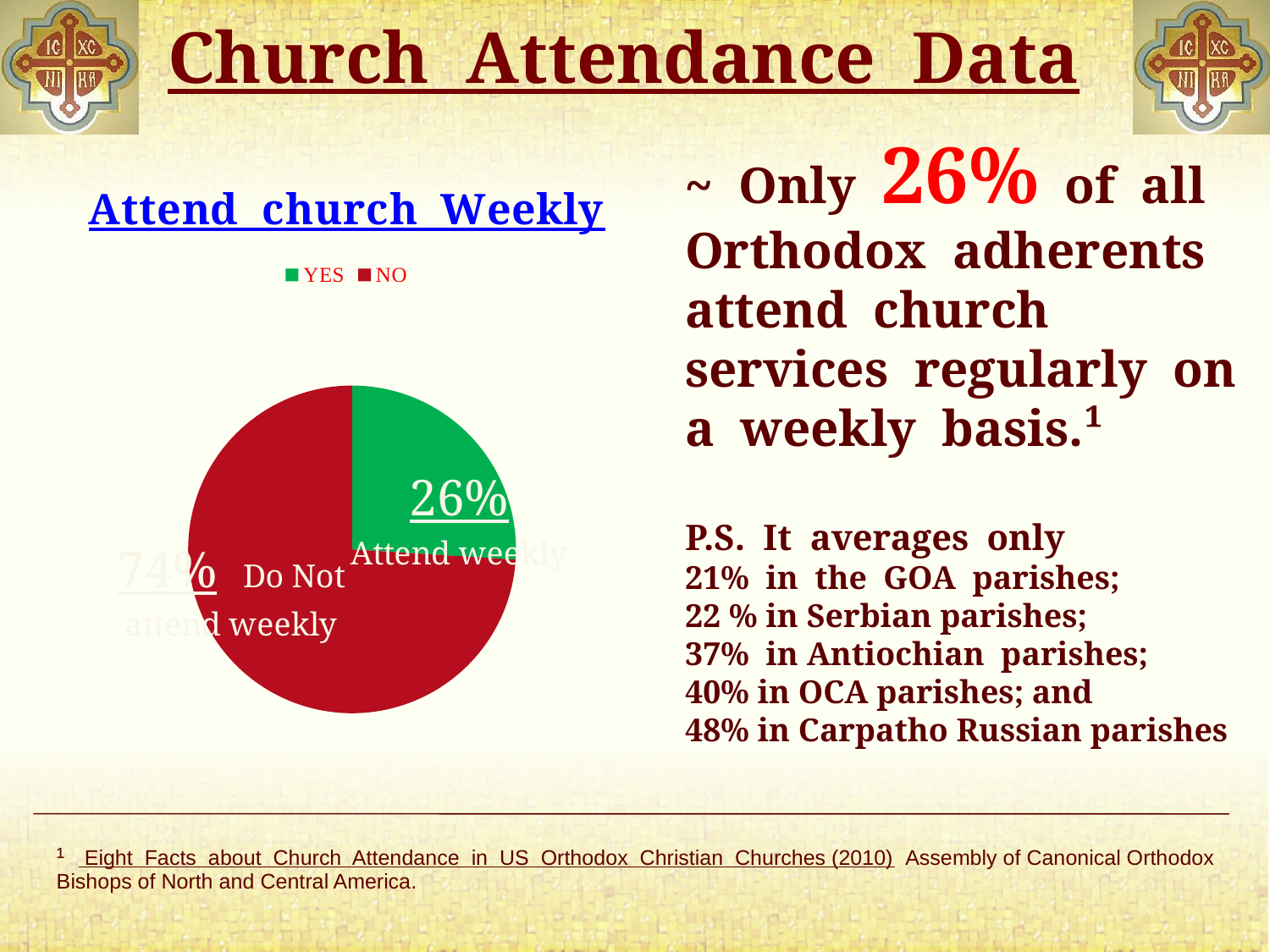
How many entries does the chart legend list? 2 What share of the pie is labelled 'Do Not attend weekly'? 74% How many slices does the pie chart have? 2 What colour is the YES slice in the pie chart? green Which slice of the pie is the largest? NO (Do Not attend weekly) Which slice of the pie is the smallest? YES (Attend weekly) Which is larger, the YES slice or the NO slice? NO What kind of chart is shown on the slide? pie chart What is the title of the chart? Attend church Weekly Is the share for 'Attend weekly' greater or less than 50%? less What share of the pie is labelled 'Attend weekly'? 26% What is the difference in percentage points between the 'Do Not attend weekly' slice and the 'Attend weekly' slice? 48